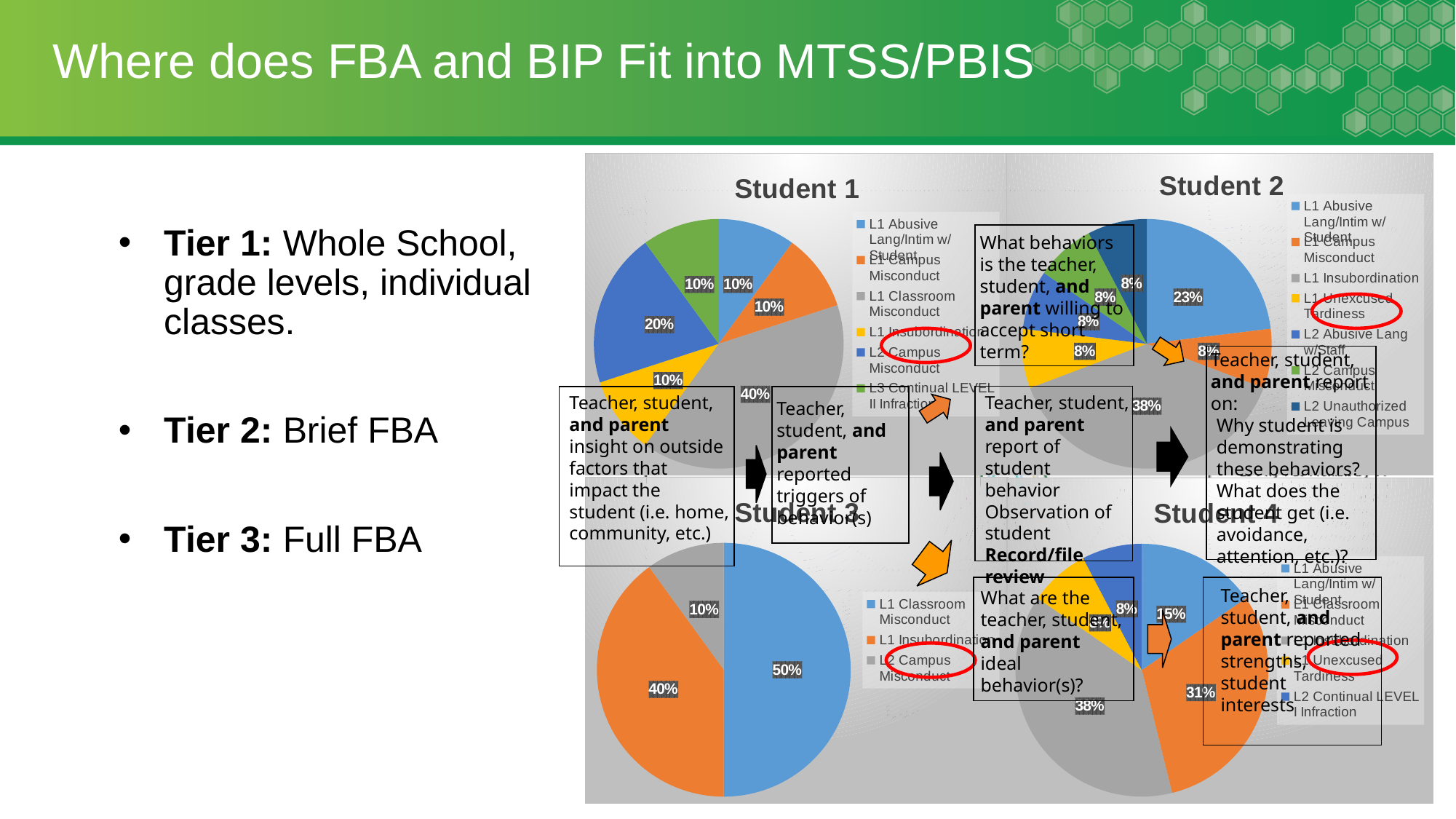
In the Student 3 pie chart, what share does the orange slice have? 40% In the Student 2 pie chart, what share does the blue slice have? 23% What kind of chart is used for Student 1? Pie chart How many entries does the legend of the Student 3 pie chart list? 3 In the Student 2 pie chart, what is the share of the largest slice? 38% How many slices does the Student 3 pie chart have? 3 In the Student 3 pie chart, which slice is larger: the blue slice or the orange slice? Blue slice In the Student 4 pie chart, what is the difference between the largest slice (38%) and the blue slice (15%)? 23%